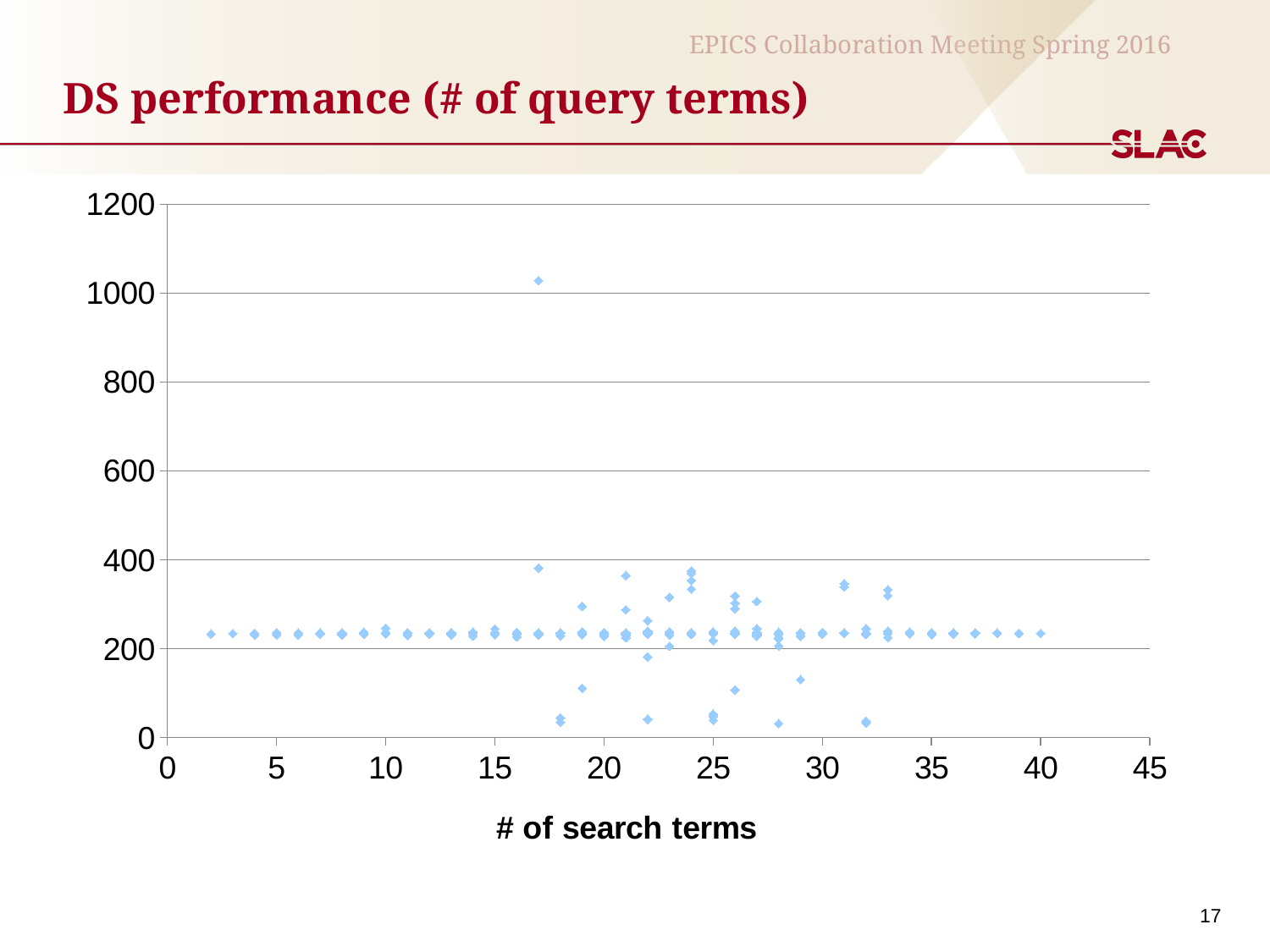
What kind of chart is shown on the slide? scatter chart Is the highest point at 21 search terms greater or less than 200? greater What is the label of the x axis? # of search terms Is the value plotted at 40 search terms greater or less than 600? less What is the maximum value shown on the y axis? 1200 Is the highest point at 17 search terms greater or less than the highest point at 24 search terms? greater Is the value plotted at 2 search terms greater or less than 400? less What is the title of the chart? DS performance (# of query terms)